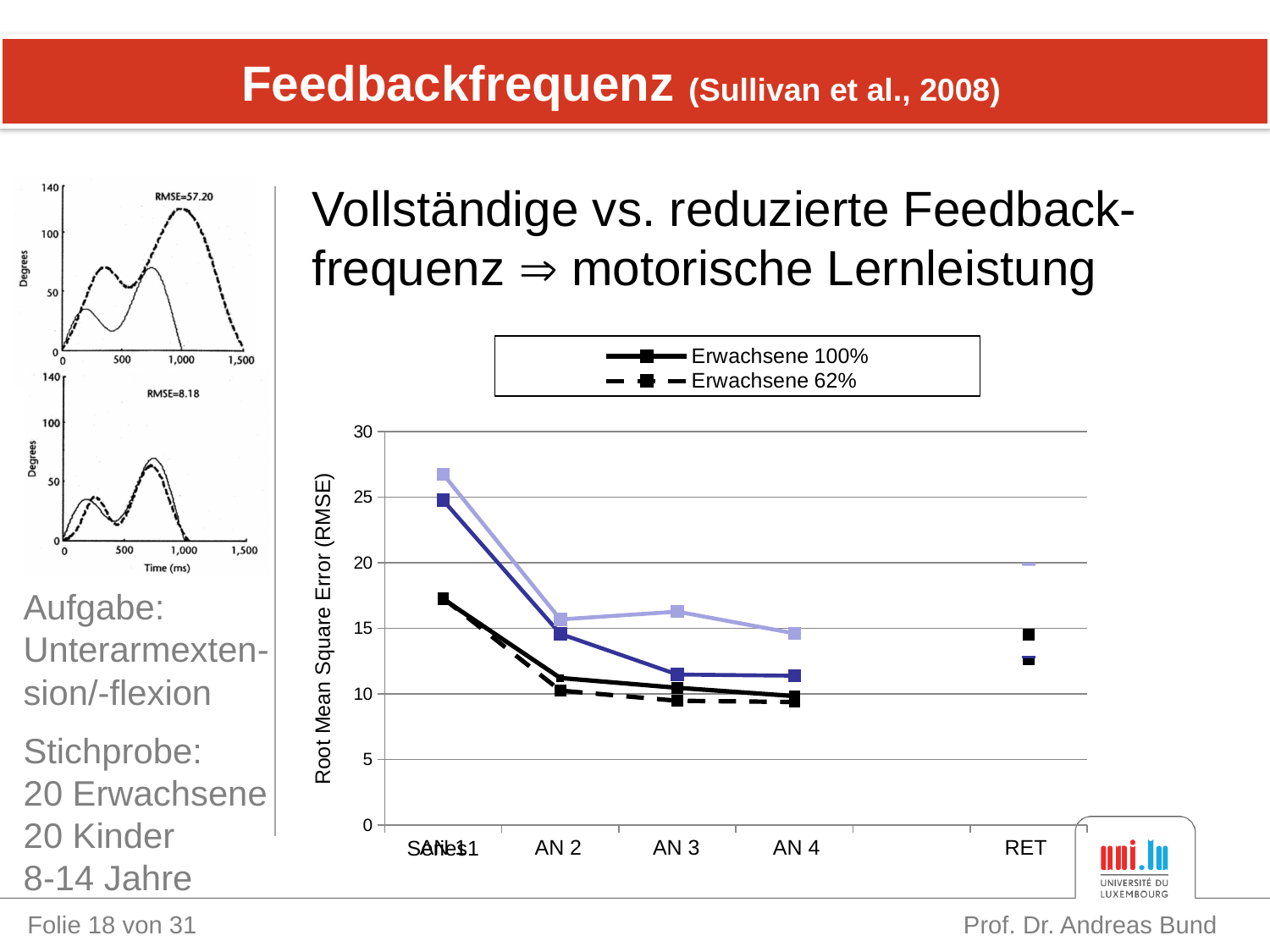
In the main chart, does the Erwachsene 100% line rise or fall from AN 1 to AN 4? fall In the main chart, is the value for Erwachsene 100% at AN 2 greater or less than 10? greater In the top-left small chart, what RMSE value is printed? RMSE=57.20 In the main chart, is the value for Erwachsene 100% larger at AN 1 or at AN 4? AN 1 In the main chart, what are the two entries in the legend? Erwachsene 100% and Erwachsene 62% In the main chart, how many x-axis categories are labelled with 'AN'? 4 In the main chart, is the value for Erwachsene 100% at AN 1 greater or less than 15? greater In the main chart, how many series does the legend list? 2 In the main chart, what is the label of the y axis? Root Mean Square Error (RMSE) In the main chart, is the value for Erwachsene 62% at AN 4 greater or less than 10? less In the main chart, at which AN category is the Erwachsene 62% line highest? AN 1 What kind of chart is the main chart on the right of the slide? line chart